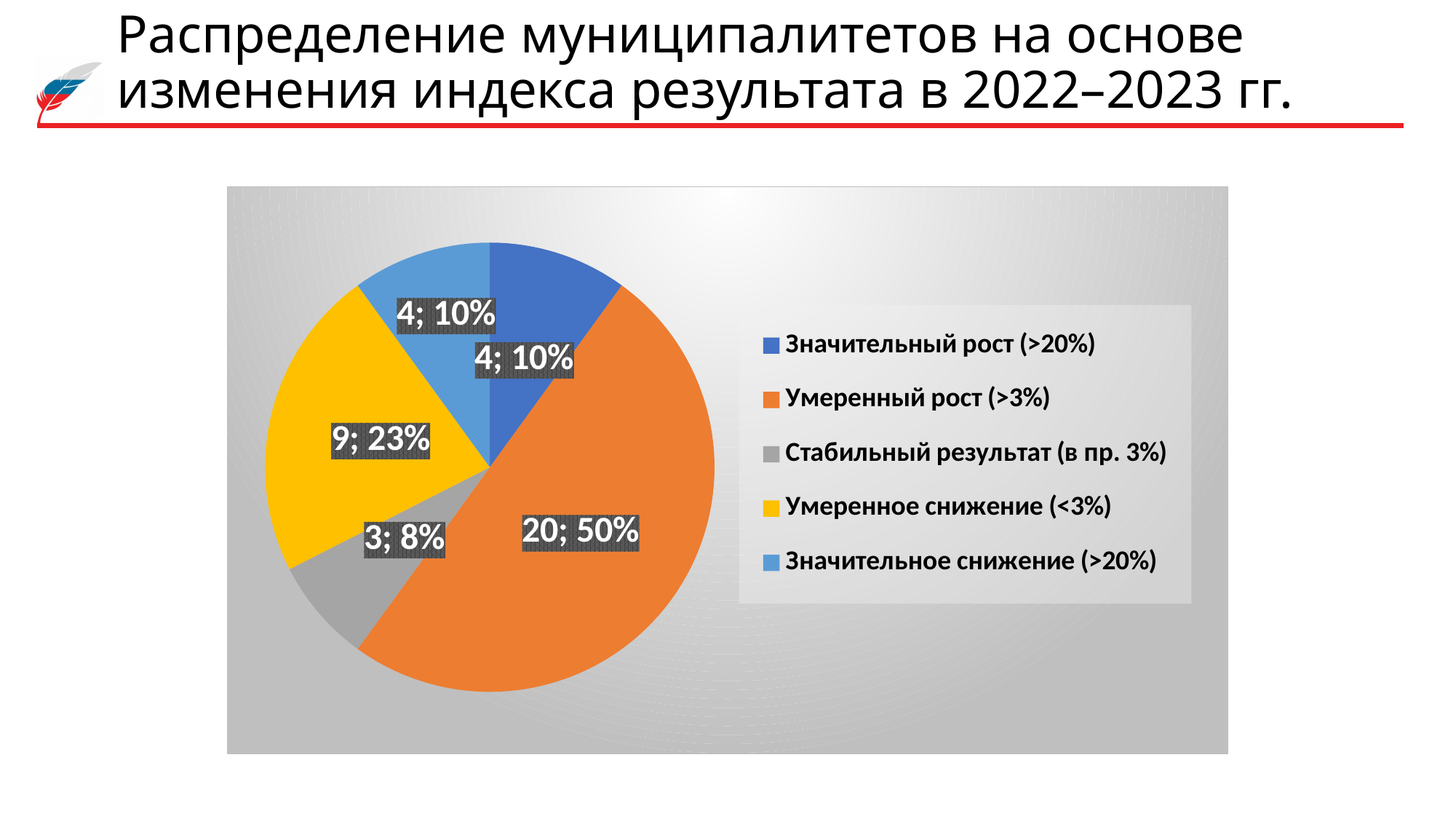
How many categories does the pie chart have? 5 What share of the pie does "Умеренный рост (>3%)" take? 50% How many municipalities are in the "Умеренное снижение (<3%)" category? 9 Which category has the largest slice of the pie? Умеренный рост (>3%) What percentage of the pie is "Стабильный результат (в пр. 3%)"? 8% Which has more municipalities: "Умеренное снижение (<3%)" or "Значительное снижение (>20%)"? Умеренное снижение (<3%) What colour is the slice for "Умеренное снижение (<3%)"? yellow Which category has the smallest slice of the pie? Стабильный результат (в пр. 3%) How many municipalities are in the "Значительный рост (>20%)" category? 4 What is the difference in the number of municipalities between "Умеренный рост (>3%)" and "Умеренное снижение (<3%)"? 11 How many municipalities fall into the "Умеренный рост (>3%)" category? 20 What kind of chart is shown on the slide? pie chart